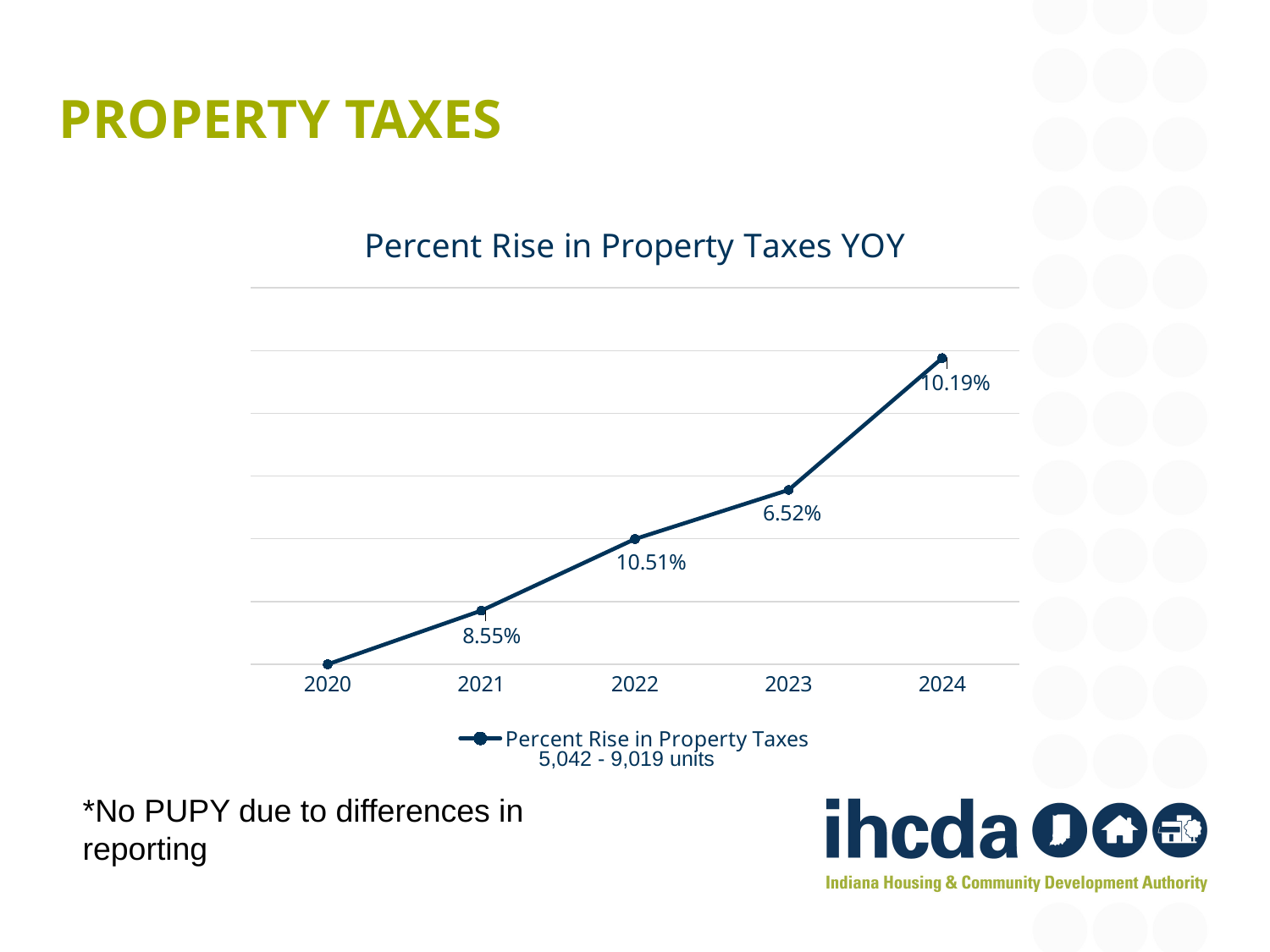
Does the plotted line rise or fall from 2020 to 2024? Rise How many years are shown on the x axis of the chart? 5 What kind of chart is shown on the slide? Line chart What is the difference between the 2024 data label and the 2023 data label? 3.67% What is the data label for 2024 in the chart? 10.19% What is the data label for 2021 in the Percent Rise in Property Taxes YOY chart? 8.55% What is the data label for 2022 in the chart? 10.51% Which year's data label shows the larger value, 2022 or 2023? 2022 What is the data label for 2023 in the chart? 6.52% Which year's data label shows the larger value, 2021 or 2024? 2024 How many series does the chart legend list? 1 What is the difference between the 2022 data label and the 2021 data label? 1.96%